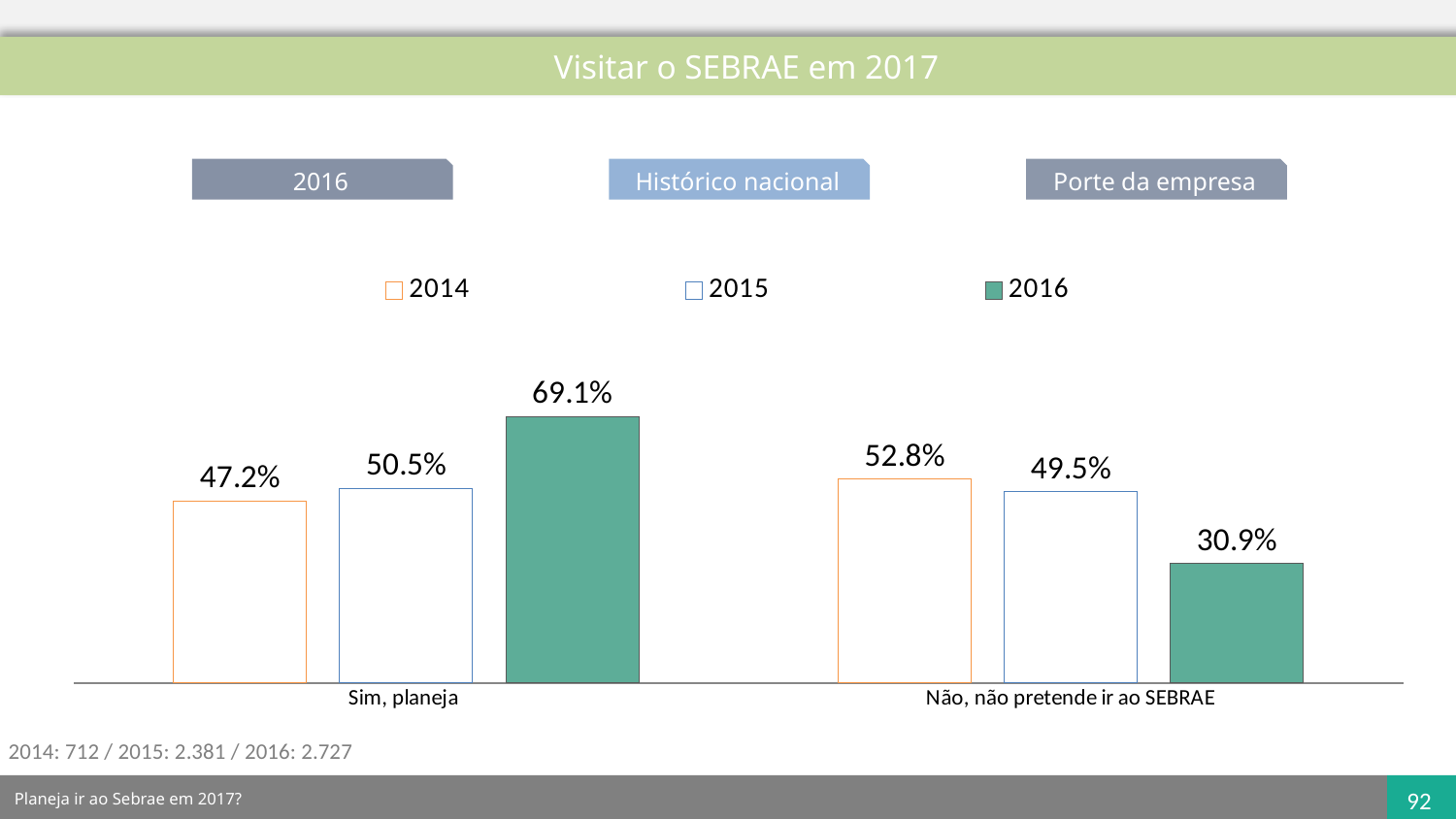
Do the values for "Sim, planeja" rise or fall from 2014 to 2016? Rise What is the title of the slide containing the chart? Visitar o SEBRAE em 2017 What is the difference between the 2016 and 2014 values in the "Sim, planeja" category? 21.9% What is the value for 2016 in the "Sim, planeja" category? 69.1% How many series does the legend list? 3 Which year has the lowest value in the "Não, não pretende ir ao SEBRAE" category? 2016 What is the value for 2015 in the "Sim, planeja" category? 50.5% What is the value for 2014 in the "Não, não pretende ir ao SEBRAE" category? 52.8% What kind of chart is shown on the slide? Bar chart How many categories are shown on the x axis? 2 Which year has the highest value in the "Sim, planeja" category? 2016 Which is larger: the 2015 value for "Sim, planeja" or the 2015 value for "Não, não pretende ir ao SEBRAE"? Sim, planeja